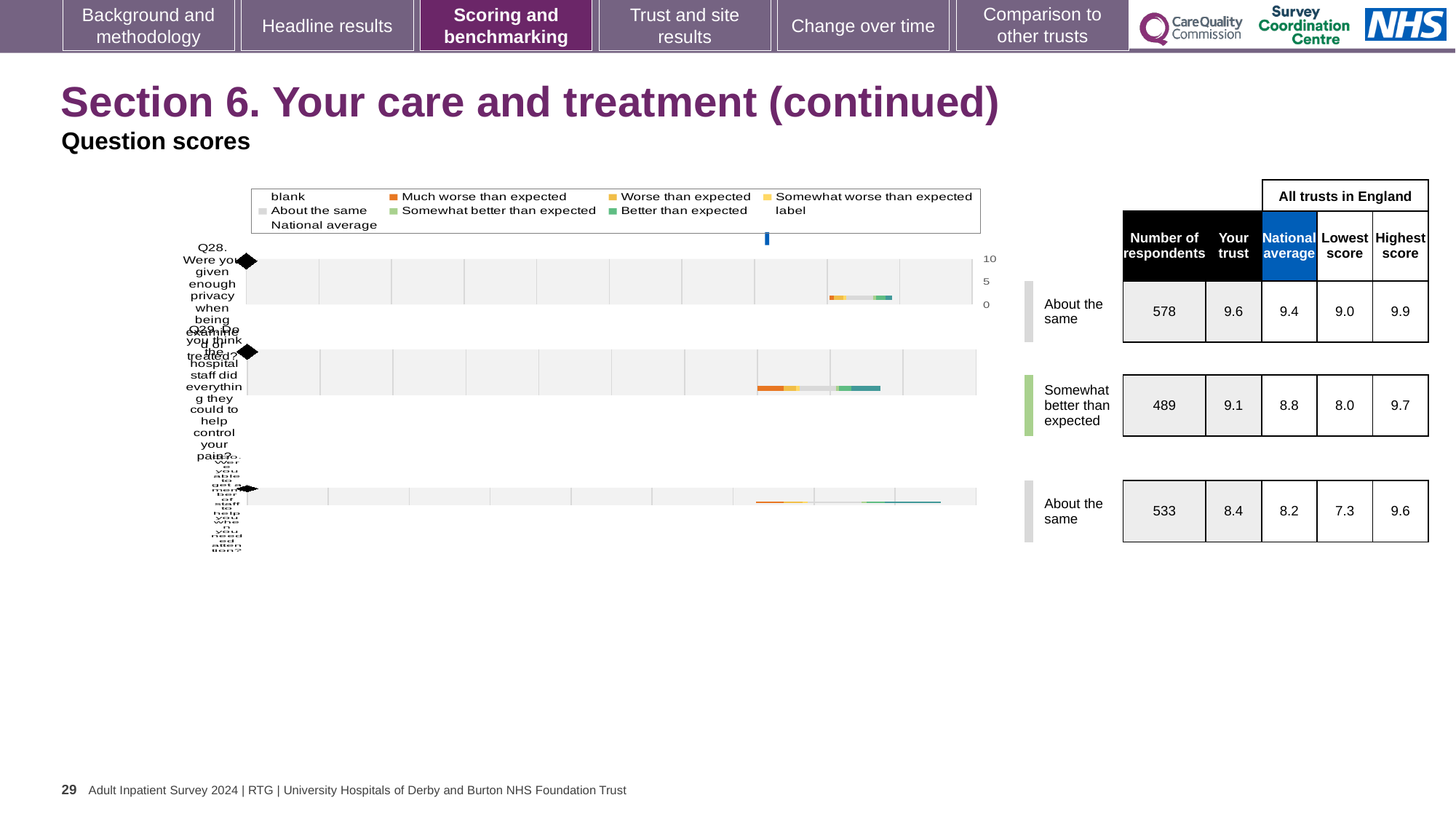
What is the 'Your trust' score for Q28 (Were you given enough privacy when being examined or treated?)? 9.6 Which benchmark category is the trust's Q29 score placed in? Somewhat better than expected What is the highest score across all trusts in England for Q28? 9.9 Which question has the fewest respondents? Q29 (489) Which question has the highest 'Your trust' score on this slide? Q28 (9.6) What is the national average score for Q29 (Do you think the hospital staff did everything they could to help control your pain?)? 8.8 By how much does the trust's score for Q28 exceed the national average? 0.2 How many questions are shown on this slide? 3 What kind of chart is used to show the question scores? Bar chart For Q29, which is higher: the trust's score or the national average? The trust's score (9.1) How many respondents answered Q30 (Were you able to get a member of staff to help you when you needed attention?)? 533 What is the lowest score across all trusts in England for Q30? 7.3